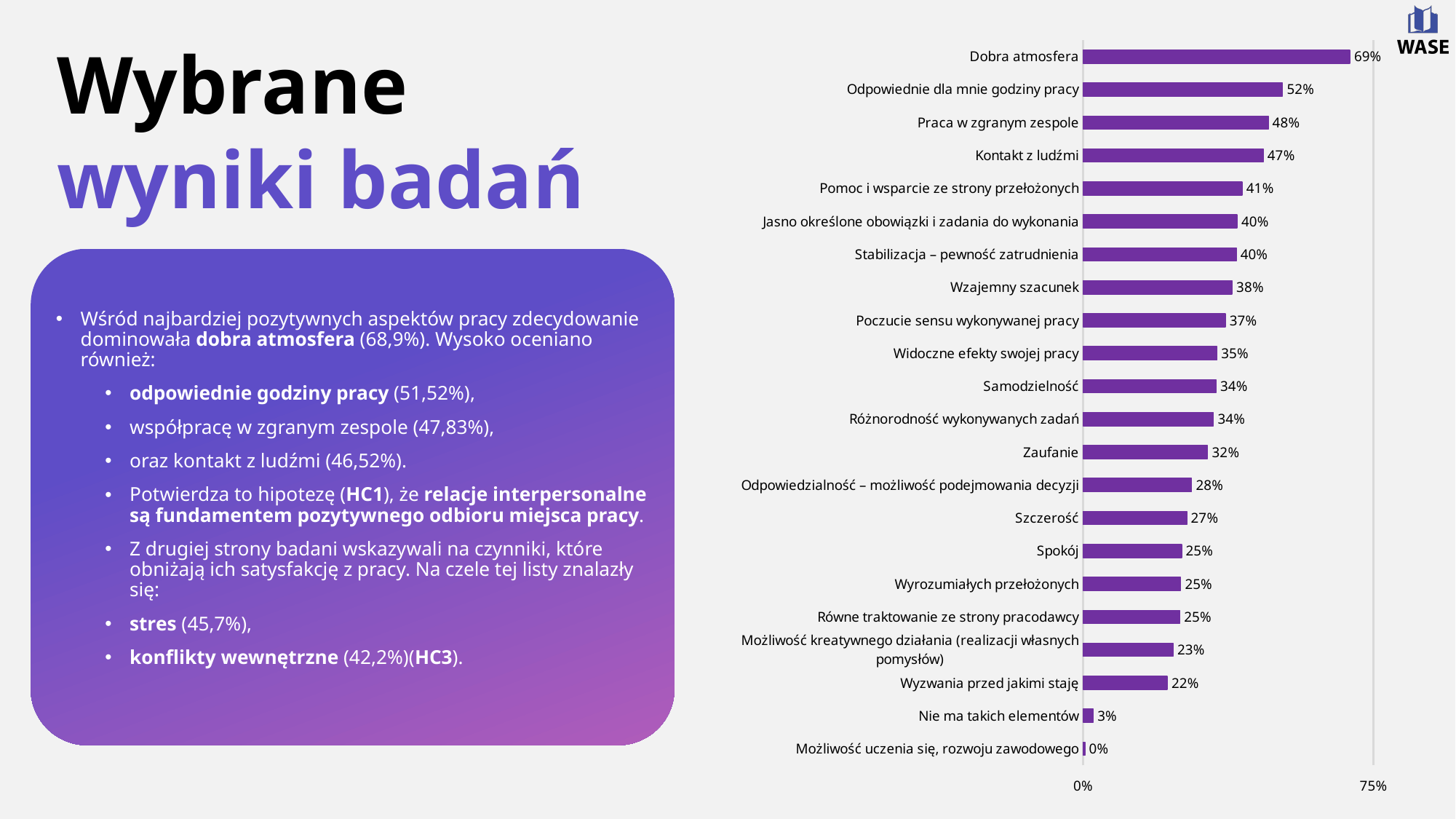
Which category has the highest value? Dobra atmosfera What is the value for "Zaufanie"? 32% What is the difference between "Dobra atmosfera" and "Odpowiednie dla mnie godziny pracy"? 17% What is the value for "Nie ma takich elementów"? 3% Which category has the lowest value? Możliwość uczenia się, rozwoju zawodowego What is the difference between "Praca w zgranym zespole" and "Wyzwania przed jakimi staję"? 26% How many categories are shown in the chart? 22 What kind of chart is shown on the slide? Bar chart What is the value for "Kontakt z ludźmi"? 47% Which is larger: "Szczerość" or "Spokój"? Szczerość What is the value for "Dobra atmosfera"? 69% What is the maximum value shown on the chart's axis? 75%